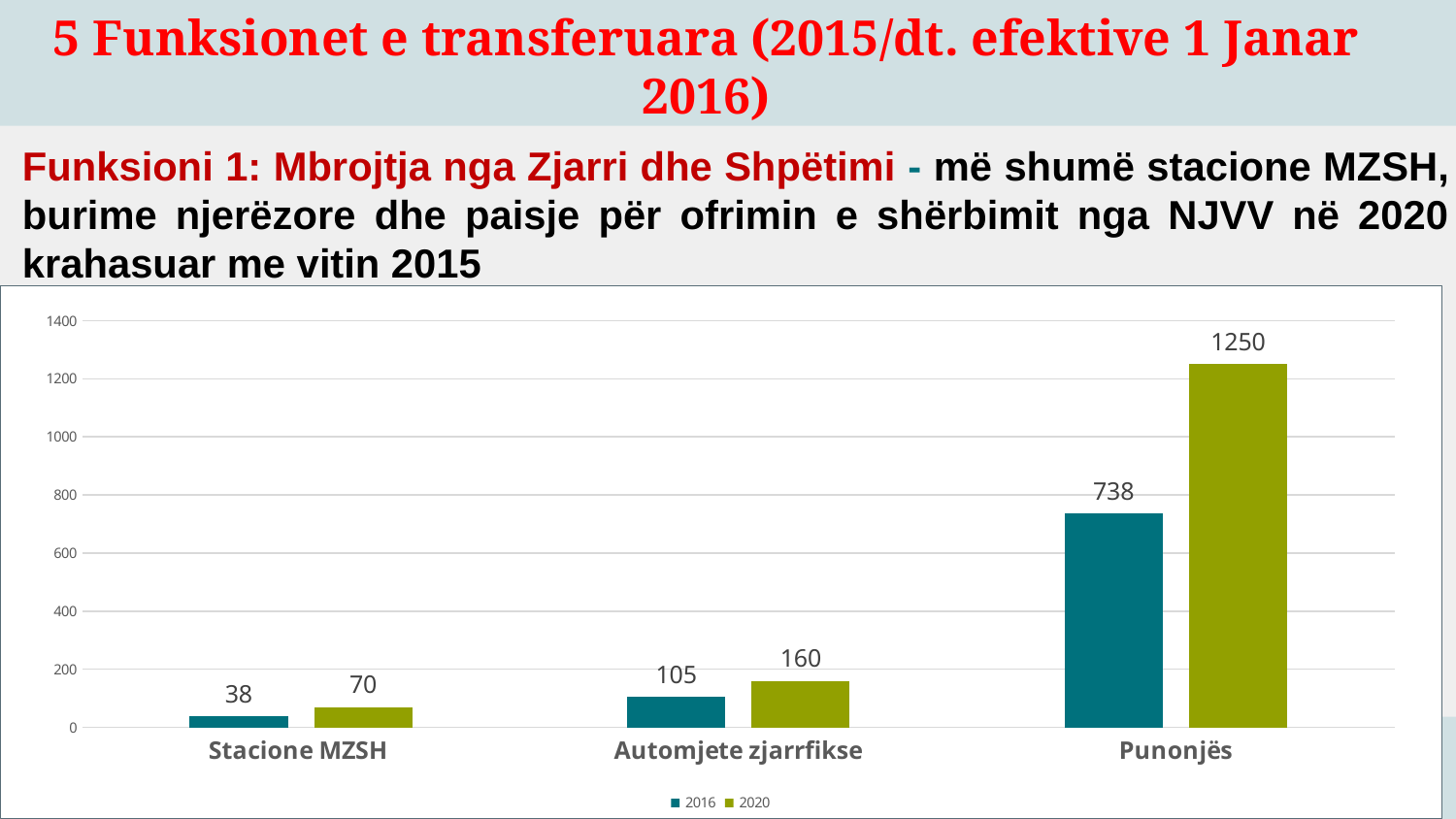
What is the value for Automjete zjarrfikse in 2020? 160 Is the 2016 value for Punonjës greater or less than 600? greater What is the value for Stacione MZSH in 2016? 38 What is the difference between the 2020 and 2016 values for Punonjës? 512 How many categories are shown on the x axis? 3 How many series does the legend list? 2 What kind of chart is shown on the slide? bar chart Which is larger for Stacione MZSH, the 2016 value or the 2020 value? 2020 Which category has the highest value in 2020? Punonjës Which category has the lowest value in 2016? Stacione MZSH What is the value for Punonjës in 2020? 1250 What is the difference between the 2020 and 2016 values for Automjete zjarrfikse? 55